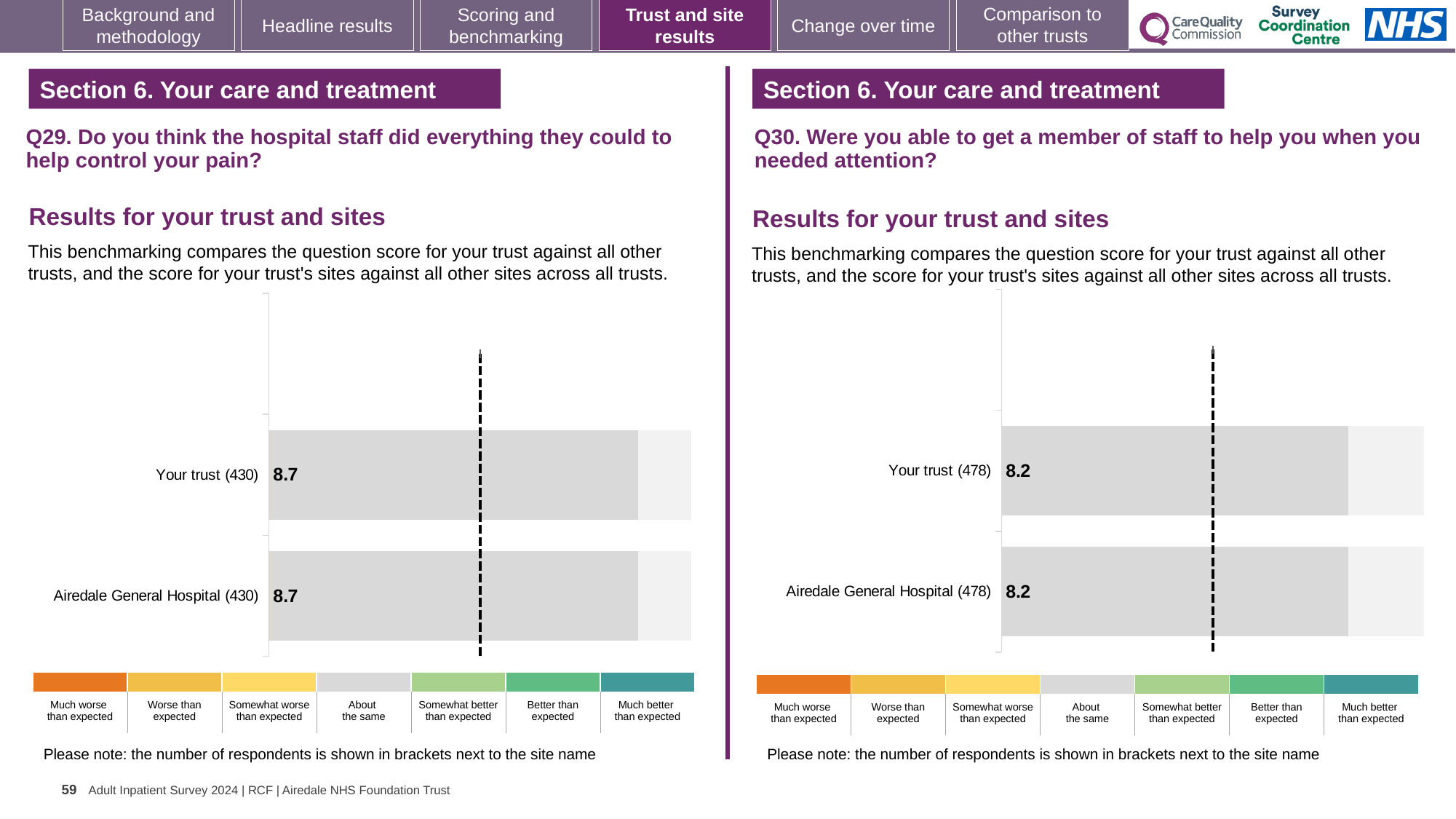
On the Q30 chart (right), what is the difference between the score for Your trust and the score for Airedale General Hospital? 0 How many bars are plotted on the Q29 chart (left)? 2 On the Q30 chart (right), what is the score for Your trust (478)? 8.2 On the Q29 chart (left), how many respondents are shown in brackets next to Your trust? 430 On the Q30 chart (right), what is the score for Airedale General Hospital (478)? 8.2 Is the score for Your trust on the Q29 chart (left) larger or smaller than the score for Your trust on the Q30 chart (right)? Larger On the Q29 chart (left), what is the difference between the score for Your trust and the score for Airedale General Hospital? 0 On the Q29 chart (left), what is the score for Your trust (430)? 8.7 On the Q30 chart (right), how many respondents are shown in brackets next to Airedale General Hospital? 478 How many bars are plotted on the Q30 chart (right)? 2 What kind of chart is used on the Q29 chart (left)? Bar chart On the Q29 chart (left), what is the score for Airedale General Hospital (430)? 8.7